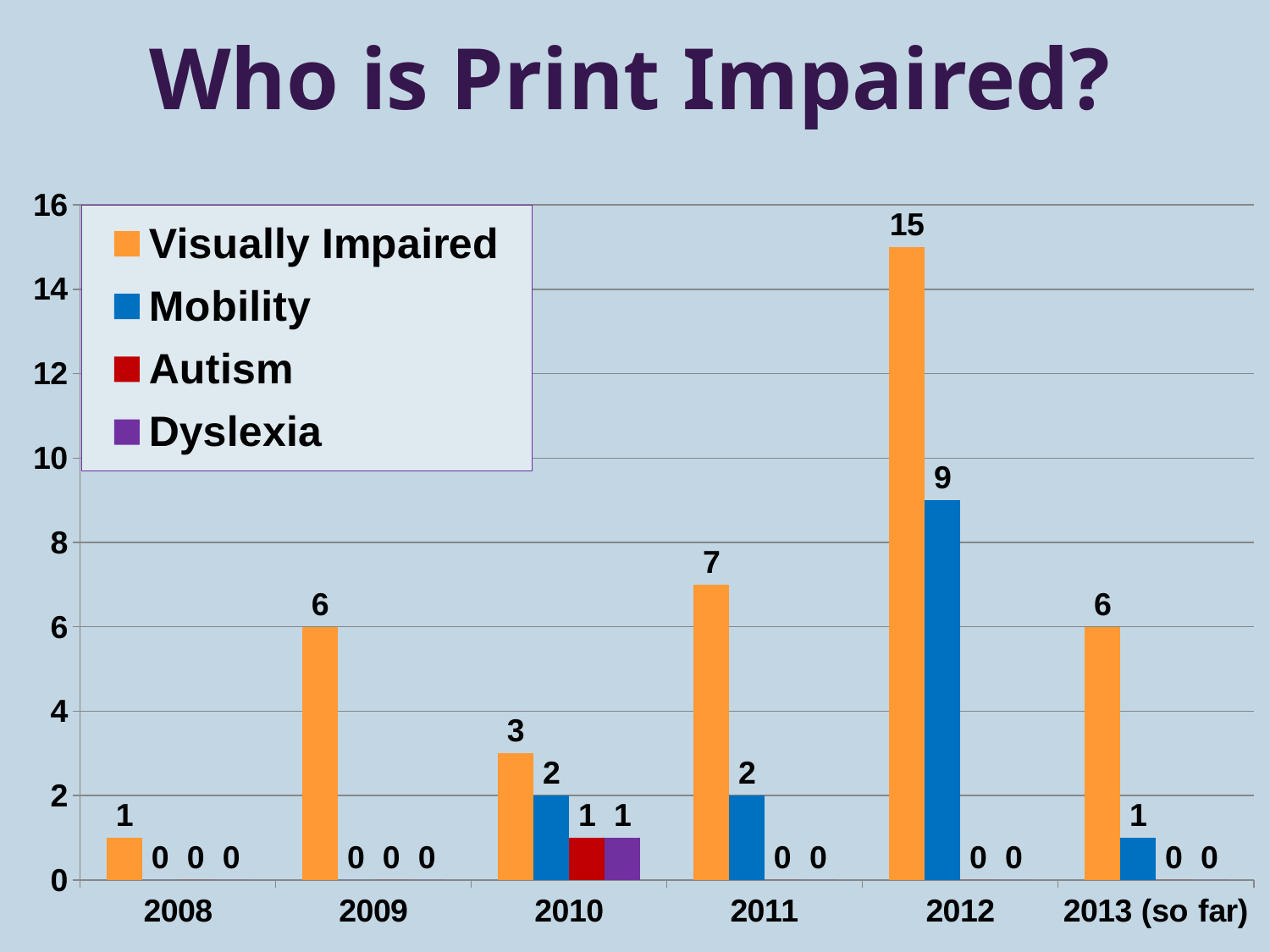
What is the value for Mobility in 2013 (so far)? 1 What is the value for Autism in 2010? 1 Which year has the highest value for Visually Impaired? 2012 What is the value for Mobility in 2012? 9 How many years are shown on the x axis? 6 Which year has the lowest value for Visually Impaired? 2008 What is the title of the slide? Who is Print Impaired? What kind of chart is shown on the slide? Bar chart Which is larger in 2011, the Visually Impaired value or the Mobility value? Visually Impaired How many series does the legend list? 4 What is the value for Visually Impaired in 2012? 15 What is the difference between the Visually Impaired and Mobility values in 2012? 6